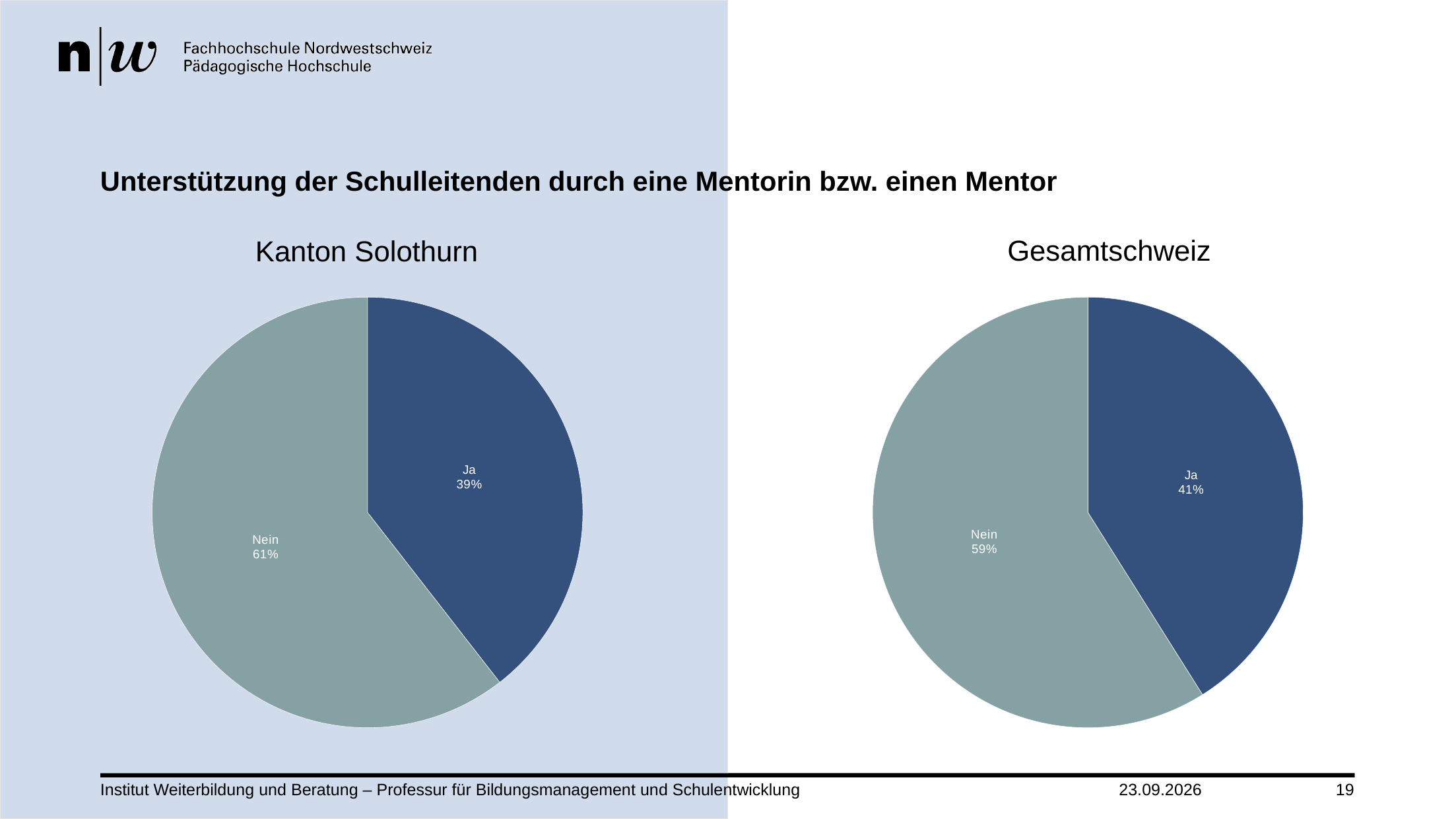
How many slices does the Gesamtschweiz chart have? 2 In the Kanton Solothurn chart, what share of the pie is labelled Nein? 61% In the Gesamtschweiz chart, what share of the pie is labelled Ja? 41% In the Kanton Solothurn chart, what is the difference between the Nein and Ja shares? 22% In the Gesamtschweiz chart, what is the difference between the Nein and Ja shares? 18% What is the title of the chart on the right side of the slide? Gesamtschweiz What kind of chart is the Kanton Solothurn chart? Pie chart In the Gesamtschweiz chart, what share of the pie is labelled Nein? 59% In the Kanton Solothurn chart, which slice is the largest? Nein Is the Ja share larger in the Kanton Solothurn chart or in the Gesamtschweiz chart? Gesamtschweiz In the Gesamtschweiz chart, which slice is the smallest? Ja